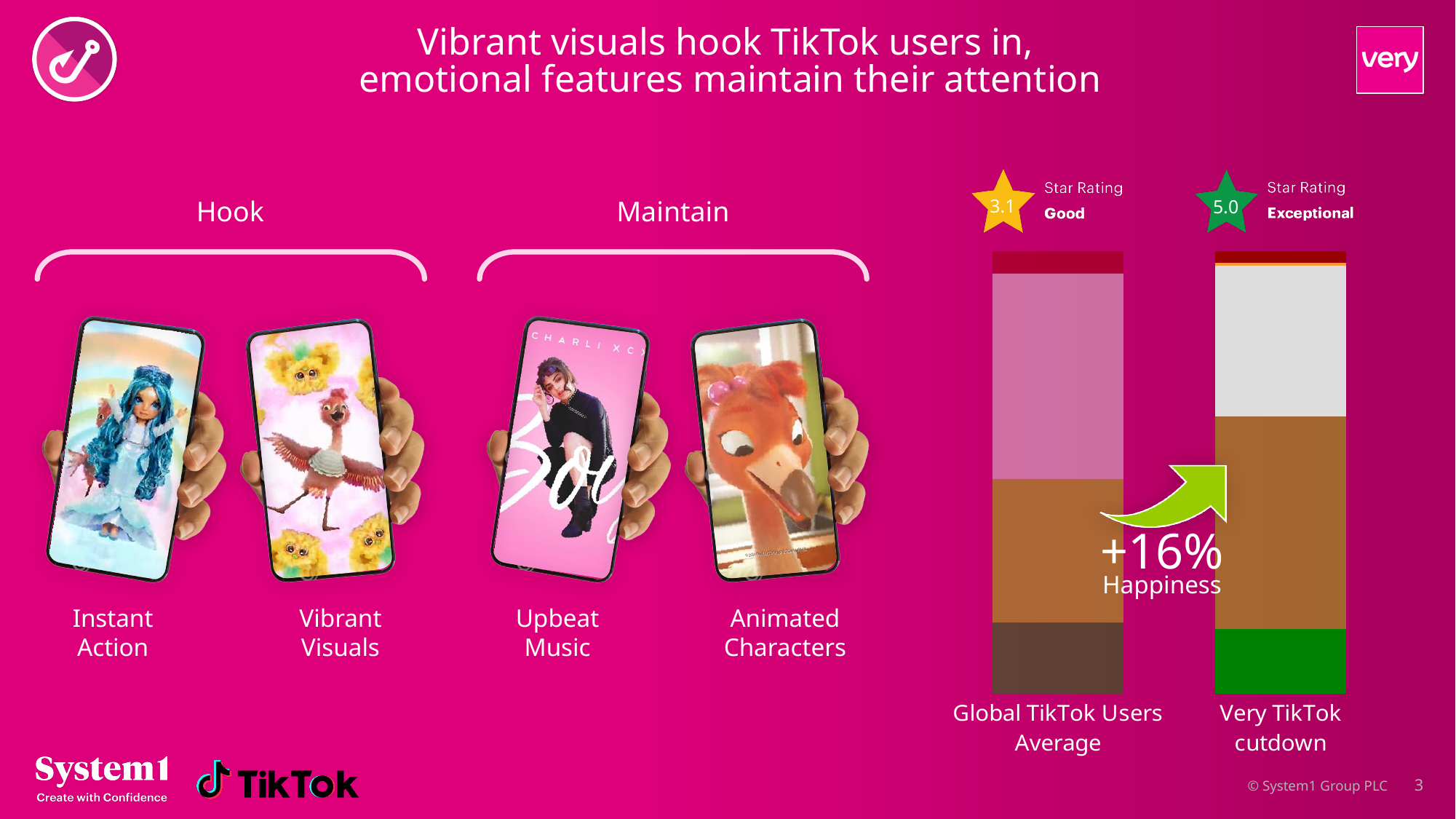
What star rating is shown above the Global TikTok Users Average bar? 3.1 What rating description accompanies the 5.0 star rating? Exceptional What is the difference between the two star ratings shown above the bars? 1.9 How many bars does the chart on the right of the slide show? 2 What star rating is shown above the Very TikTok cutdown bar? 5.0 What are the two categories labelled on the chart? Global TikTok Users Average and Very TikTok cutdown Which of the two bars has the higher star rating? Very TikTok cutdown Which bar has the larger orange-brown segment? Very TikTok cutdown What rating description accompanies the 3.1 star rating? Good Which bar has a green segment at its base? Very TikTok cutdown What percentage change in Happiness is annotated between the two bars? +16% What kind of chart is shown on the right of the slide? Stacked bar chart